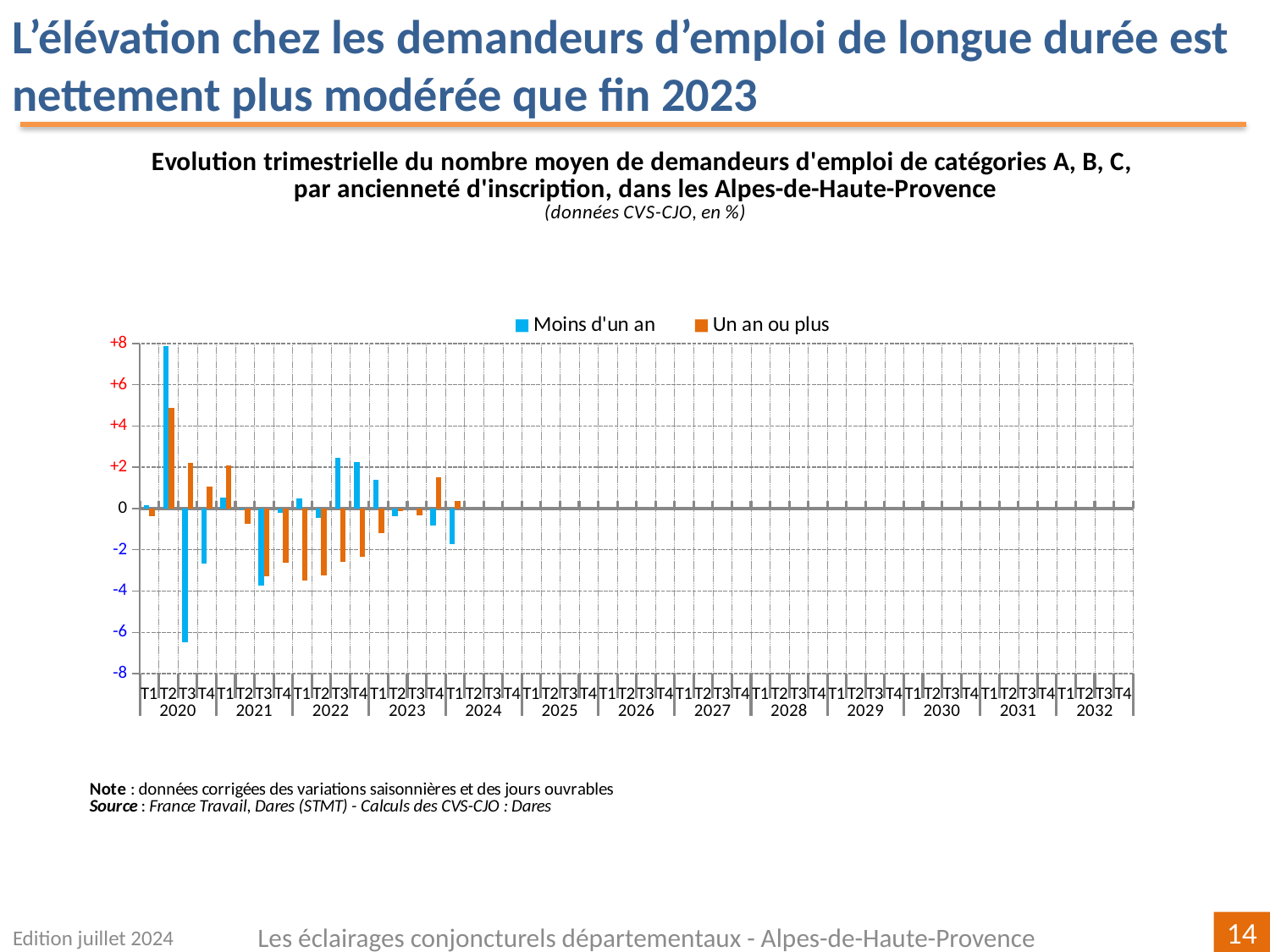
In which quarter is the 'Un an ou plus' bar the highest? T2 2020 Is the 'Un an ou plus' value for T2 2020 greater or less than +4? greater Is the 'Moins d'un an' value for T2 2020 greater or less than +6? greater In which quarter is the 'Moins d'un an' bar the lowest? T3 2020 How many series does the legend list? 2 In which quarter is the 'Moins d'un an' bar the highest? T2 2020 Is the 'Un an ou plus' value for T3 2021 greater or less than -2? less What are the two series named in the legend? Moins d'un an; Un an ou plus Which series is drawn in orange? Un an ou plus What kind of chart is shown on the slide? bar chart In T2 2020, which series has the larger value, 'Moins d'un an' or 'Un an ou plus'? Moins d'un an